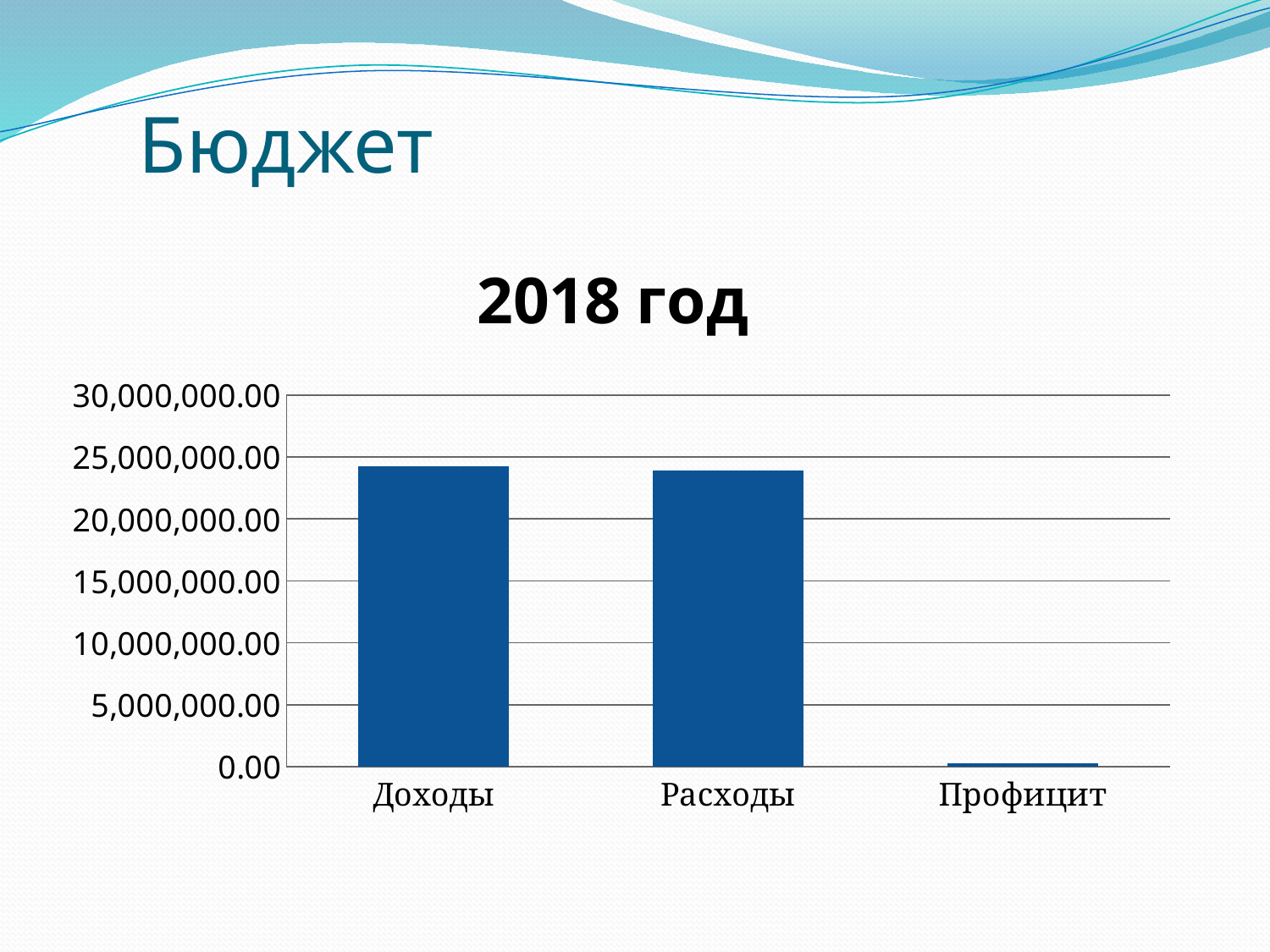
How many categories are shown on the x axis of the chart? 3 Which is larger, the value for Расходы or the value for Профицит? Расходы Is the value for Расходы greater or less than 20,000,000.00? greater Is the value for Доходы greater or less than 20,000,000.00? greater What is the highest value shown on the y axis of the chart? 30,000,000.00 What kind of chart is shown on the slide? bar chart Is the value for Расходы greater or less than 25,000,000.00? less Which category has the lowest value in the chart? Профицит Which is larger, the value for Доходы or the value for Профицит? Доходы What is the title of the chart? 2018 год Do the values rise or fall from left to right along the x axis? fall